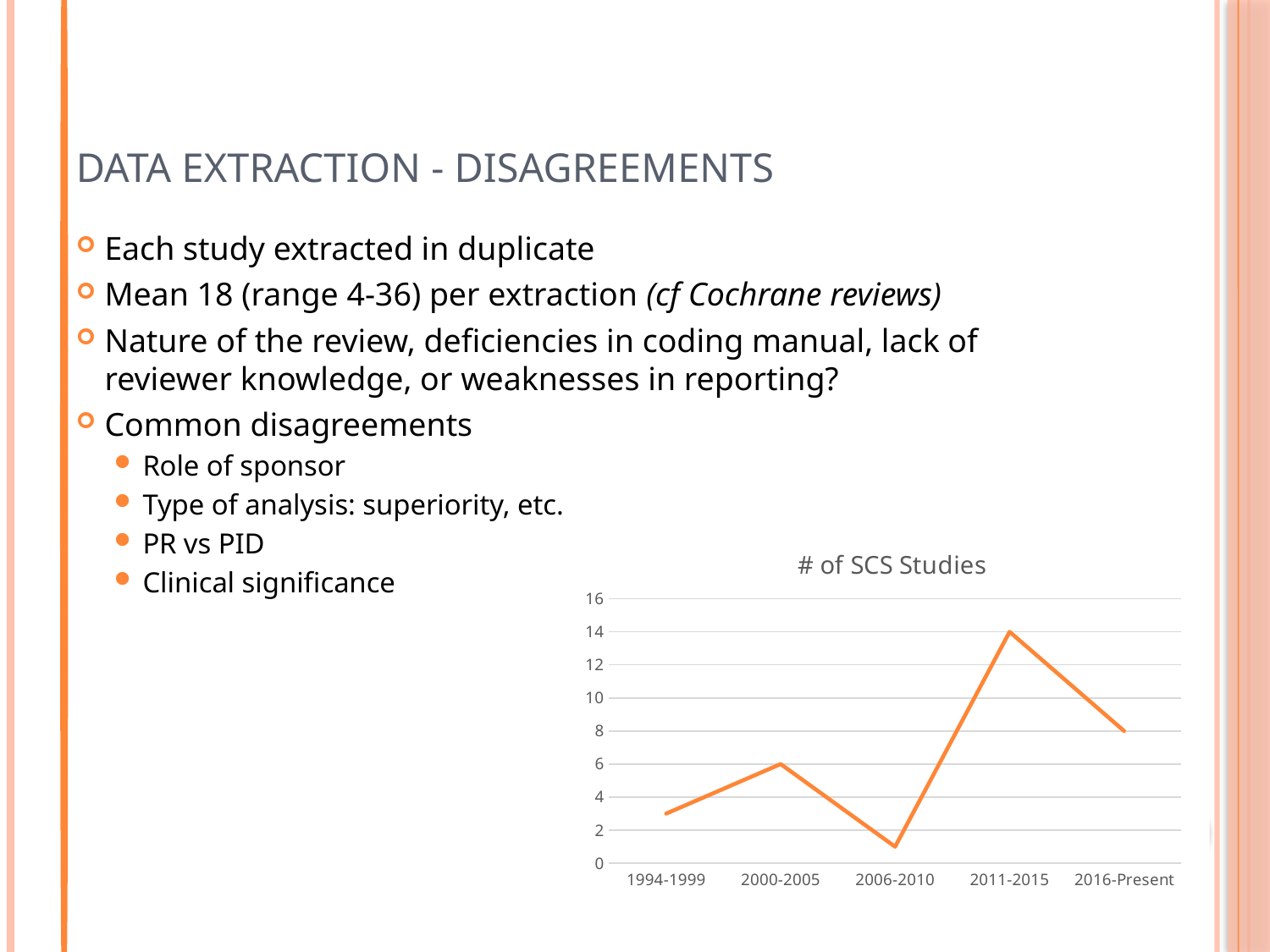
What is the difference between the number of SCS studies in 2011-2015 and 2016-Present? 6 How many time periods are plotted on the x axis of the chart? 5 Is the value for 1994-1999 greater or less than 4? less Is the value for 2006-2010 greater or less than 2? less What is the number of SCS studies for 2000-2005? 6 Which period has the lowest number of SCS studies? 2006-2010 What is the number of SCS studies for 2016-Present? 8 Does the number of SCS studies rise or fall from 2006-2010 to 2011-2015? rise What kind of chart is shown on the slide? line chart Which period has the highest number of SCS studies? 2011-2015 What is the number of SCS studies for 2011-2015? 14 What is the title of the chart? # of SCS Studies